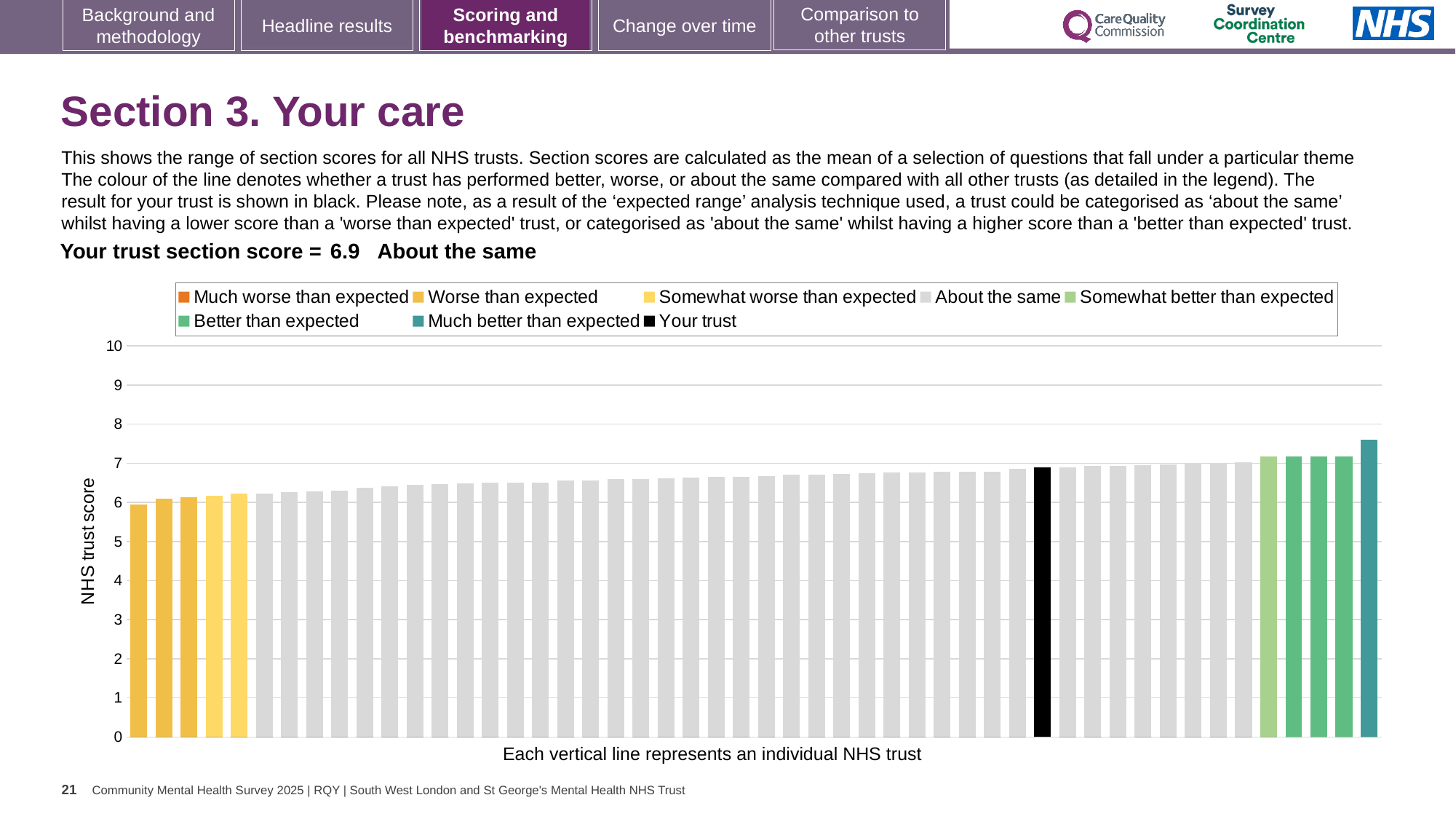
According to the legend, what does the black bar represent? Your trust Is the value of the tallest bar greater or less than 8? less Is the value of the black 'Your trust' bar greater or less than 6? greater Do the bar values rise or fall from left to right across the chart? rise What kind of chart is shown on the slide? bar chart Which is larger: the value of the black 'Your trust' bar or the value of the leftmost bar? the black 'Your trust' bar Which category is your trust's section score placed in? About the same Is the value of the shortest bar on the left greater or less than 5? greater What is the section score for your trust shown on the slide? 6.9 How many entries does the chart legend list? 8 What is the label on the vertical axis of the chart? NHS trust score